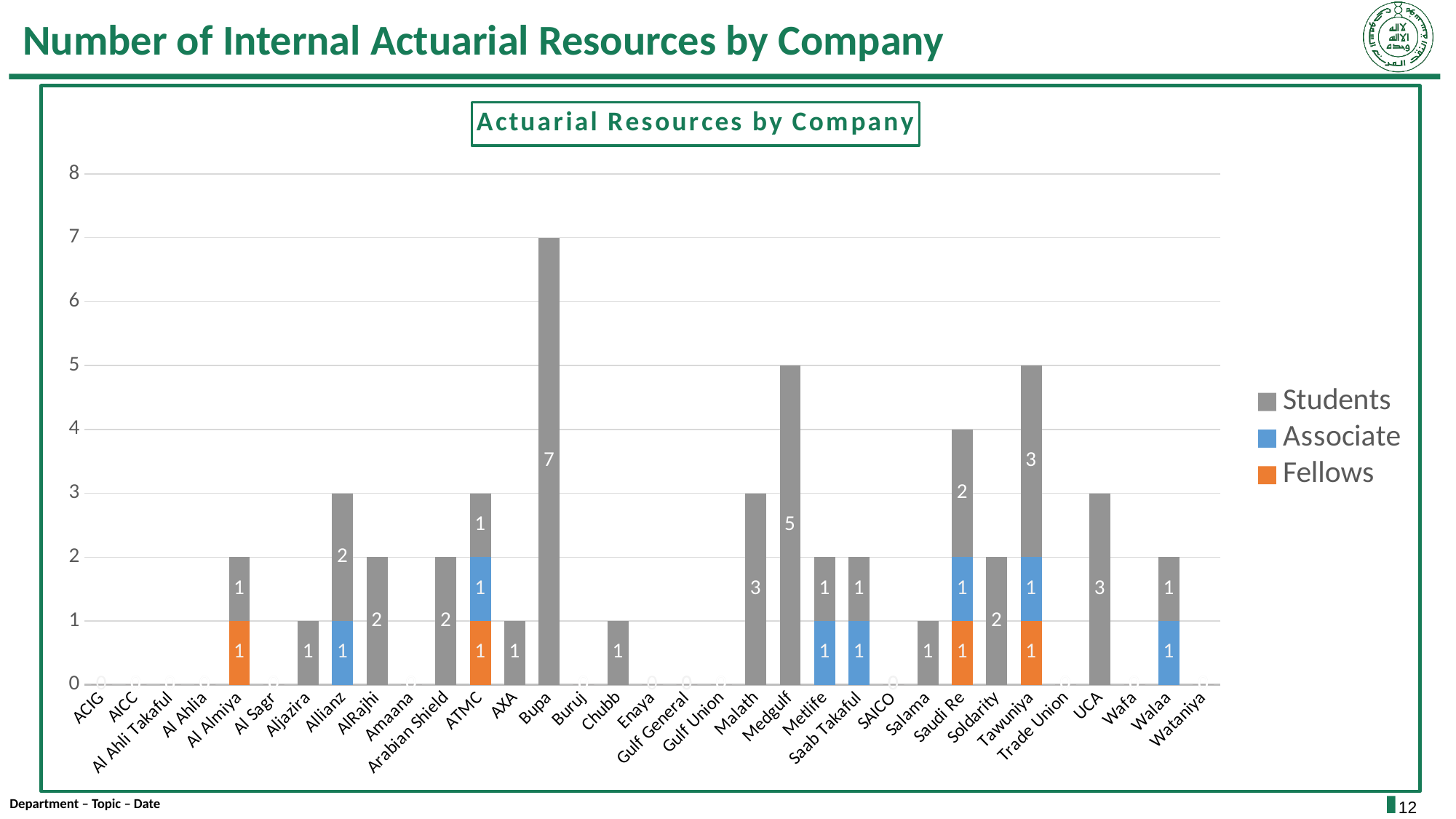
Which company has the highest number of Students? Bupa What is the difference between the number of Students at Bupa and at Medgulf? 2 What is the total number of actuarial resources for Saudi Re (all series combined)? 4 How many series does the legend list? 3 What kind of chart is shown on the slide? Stacked bar chart What is the number of Students for Medgulf? 5 What is the title of the chart? Actuarial Resources by Company What is the number of Students for Bupa? 7 How many companies are listed on the x axis? 33 Which has more Students, Medgulf or Tawuniya? Medgulf How many Fellows does ATMC have? 1 What is the total number of actuarial resources for Tawuniya (all series combined)? 5